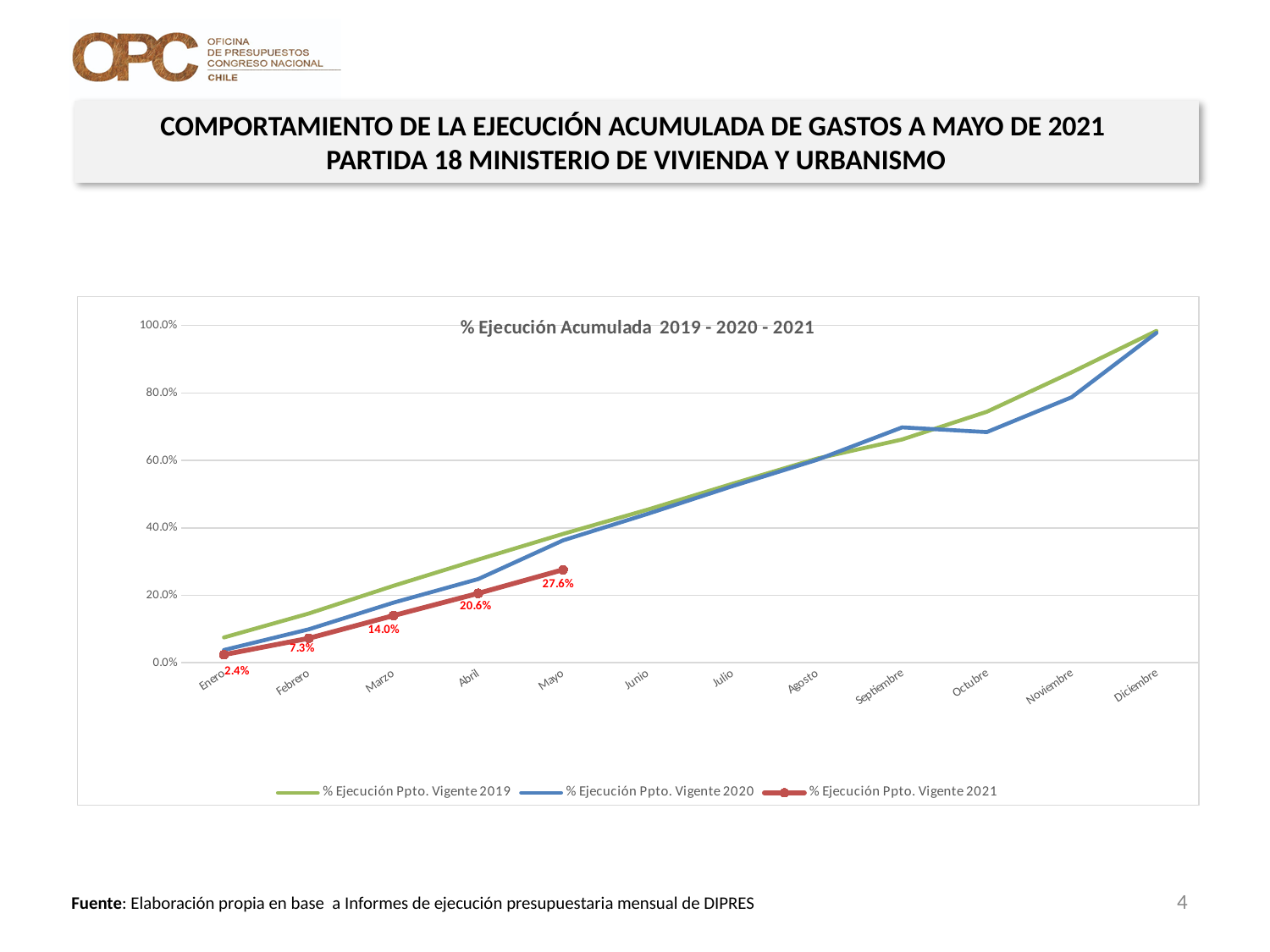
How many months are shown on the x axis? 12 In Noviembre, which series has the larger value: % Ejecución Ppto. Vigente 2019 or % Ejecución Ppto. Vigente 2020? % Ejecución Ppto. Vigente 2019 What kind of chart is shown on the slide? Line chart Which month has the highest value in the % Ejecución Ppto. Vigente 2021 series? Mayo How many series does the legend list? 3 What is the value for Marzo in the % Ejecución Ppto. Vigente 2021 series? 14.0% Which month has the lowest value in the % Ejecución Ppto. Vigente 2021 series? Enero What is the value for Enero in the % Ejecución Ppto. Vigente 2021 series? 2.4% Do the values in the % Ejecución Ppto. Vigente 2019 series rise or fall from Enero to Diciembre? Rise What is the difference between the Mayo and Abril values in the % Ejecución Ppto. Vigente 2021 series? 7.0% What is the value for Mayo in the % Ejecución Ppto. Vigente 2021 series? 27.6% Is the value for Diciembre in the % Ejecución Ppto. Vigente 2019 series greater or less than 80.0%? greater